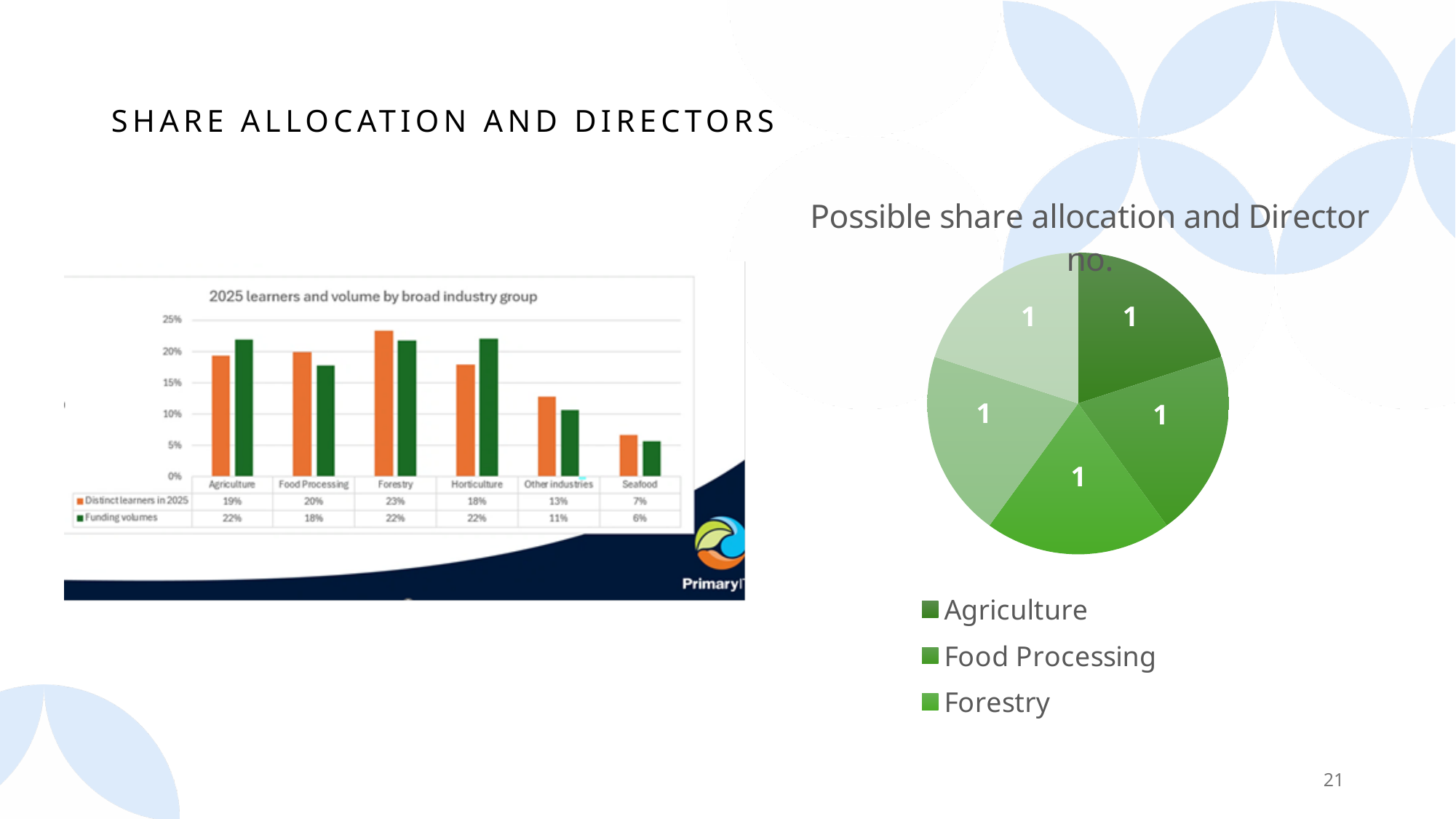
In the bar chart titled '2025 learners and volume by broad industry group', what is the value of Distinct learners in 2025 for Forestry? 23% What kind of chart is the chart on the right of the slide? pie chart In the bar chart titled '2025 learners and volume by broad industry group', which industry group has the highest value for Distinct learners in 2025? Forestry In the pie chart titled 'Possible share allocation and Director no.', how many slices are there? 5 In the bar chart titled '2025 learners and volume by broad industry group', what is the Funding volumes value for Horticulture? 22% In the pie chart titled 'Possible share allocation and Director no.', what is the data label shown on each slice? 1 In the bar chart titled '2025 learners and volume by broad industry group', what is the difference between Distinct learners in 2025 and Funding volumes for Food Processing? 2% In the bar chart titled '2025 learners and volume by broad industry group', how many industry groups are shown on the x axis? 6 In the bar chart titled '2025 learners and volume by broad industry group', which industry group has the lowest Funding volumes value? Seafood In the bar chart titled '2025 learners and volume by broad industry group', how many series does the legend list? 2 What kind of chart is the chart on the left of the slide? bar chart In the bar chart titled '2025 learners and volume by broad industry group', is the Funding volumes value for Agriculture larger or smaller than its Distinct learners in 2025 value? larger